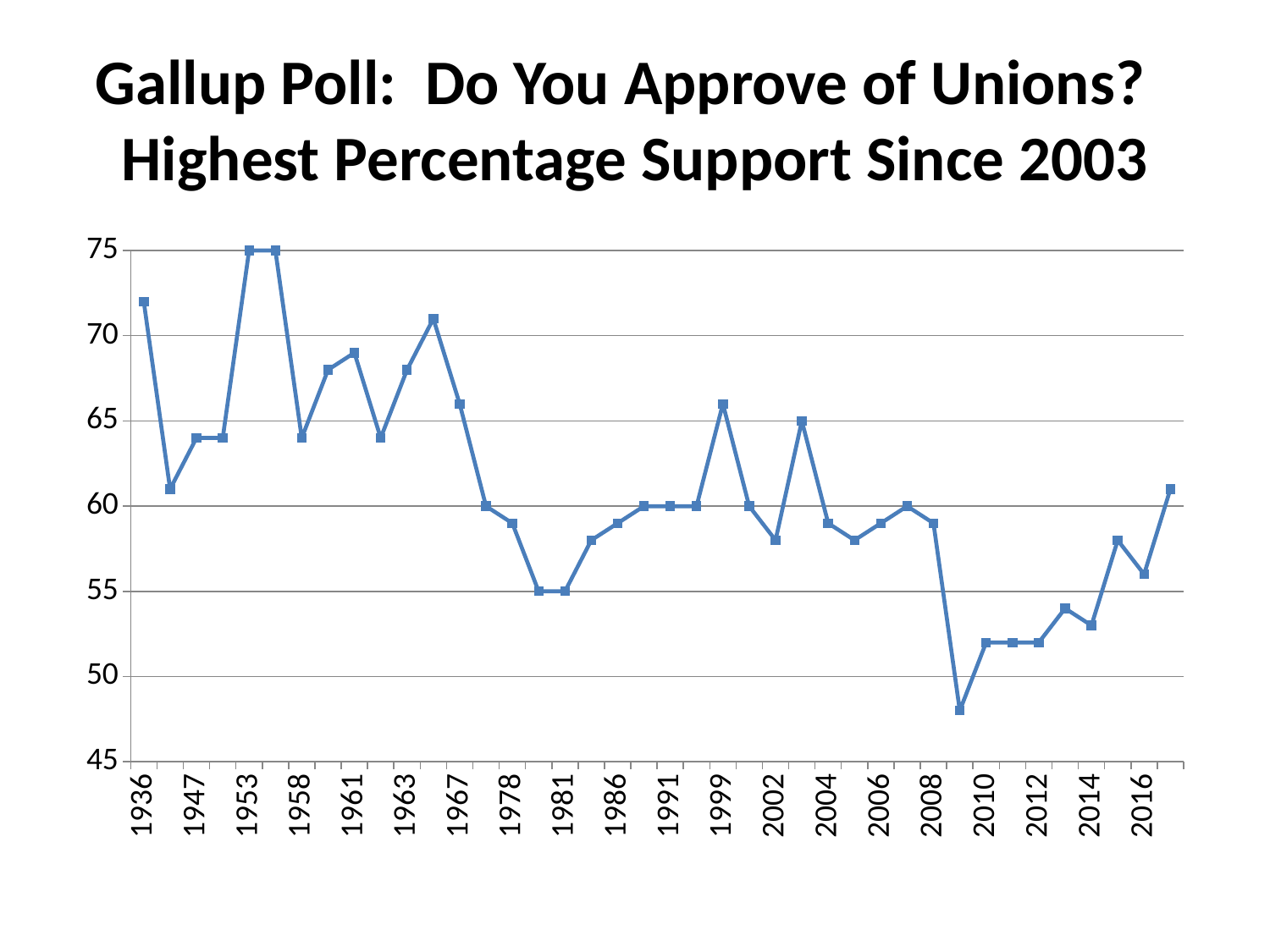
What is the highest value plotted on the chart? 75 What is the approval value for 1981? 55 What is the approval value for 1991? 60 What kind of chart is shown on the slide? line chart Do the values generally rise or fall from 2010 to 2016? rise Is the value for 2010 greater or less than 55? less What is the approval value for 1953? 75 Is the value for 1936 greater or less than 70? greater Which year has the larger value, 1953 or 1981? 1953 Is the value for 1999 greater or less than 65? greater What is the difference between the values for 1953 and 1981? 20